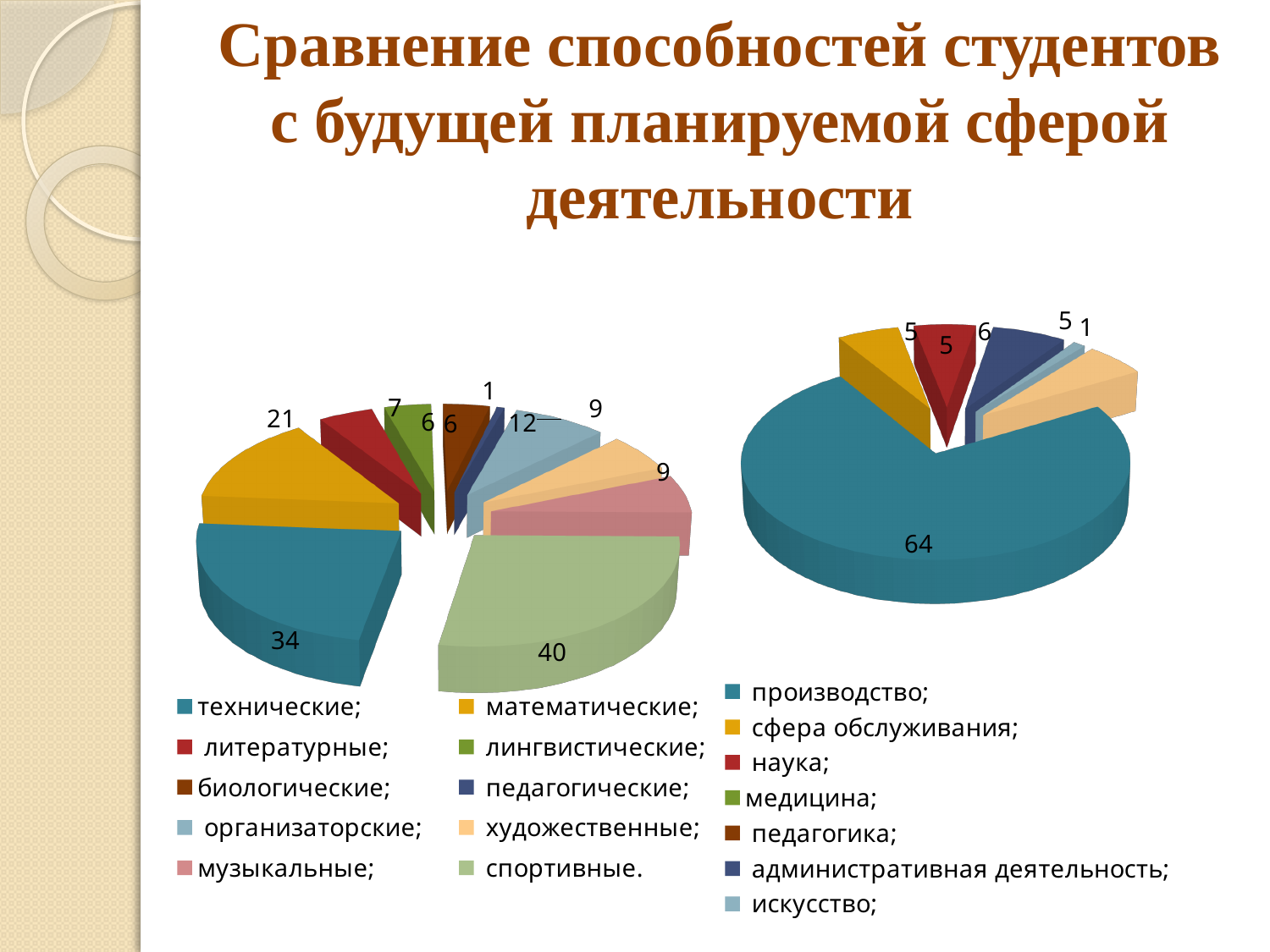
In the left pie chart (student abilities), which is larger: математические or литературные? математические In the left pie chart (student abilities), what is the difference between спортивные and технические? 6 In the left pie chart (student abilities), which category has the smallest value? педагогические In the left pie chart (student abilities), which category has the largest value? спортивные How many categories does the legend of the left pie chart (student abilities) list? 10 In the left pie chart (student abilities), what is the value for технические? 34 What kind of charts are shown on the slide? Pie charts In the left pie chart (student abilities), what is the value for организаторские? 12 In the right pie chart (planned sphere of activity), what is the value for производство? 64 In the right pie chart (planned sphere of activity), what is the value for административная деятельность? 6 In the left pie chart (student abilities), what is the value for математические? 21 In the right pie chart (planned sphere of activity), which category has the largest value? производство